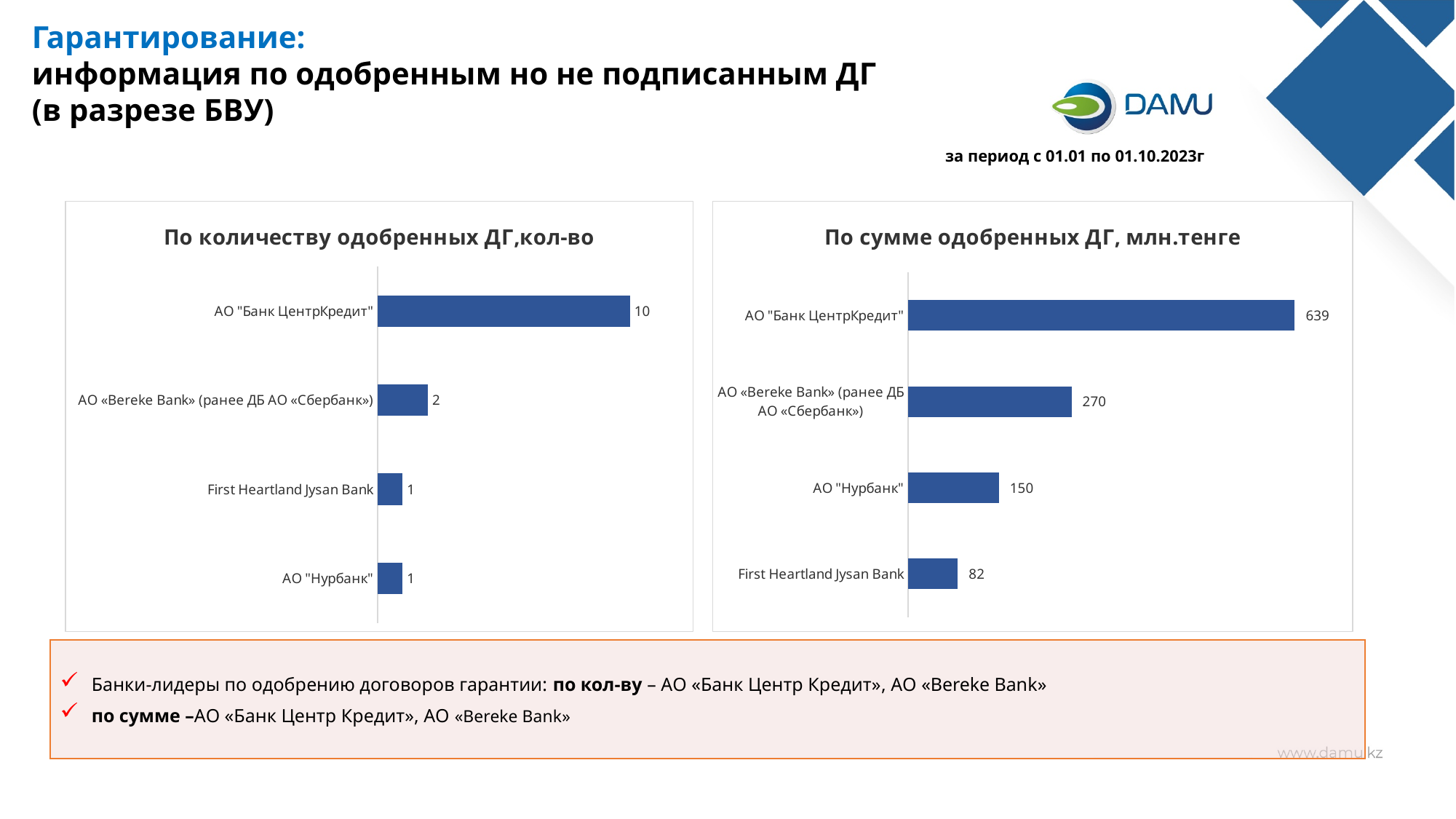
In the chart "По сумме одобренных ДГ, млн.тенге", what is the value for АО «Bereke Bank» (ранее ДБ АО «Сбербанк»)? 270 In the chart "По сумме одобренных ДГ, млн.тенге", what is the value for First Heartland Jysan Bank? 82 In the chart "По сумме одобренных ДГ, млн.тенге", what is the difference between АО "Банк ЦентрКредит" and АО «Bereke Bank» (ранее ДБ АО «Сбербанк»)? 369 In the chart "По сумме одобренных ДГ, млн.тенге", which is larger: АО "Нурбанк" or First Heartland Jysan Bank? АО "Нурбанк" In the chart "По количеству одобренных ДГ,кол-во", what is the value for АО "Банк ЦентрКредит"? 10 In the chart "По сумме одобренных ДГ, млн.тенге", which bank has the lowest value? First Heartland Jysan Bank In the chart "По количеству одобренных ДГ,кол-во", what is the difference between АО "Банк ЦентрКредит" and АО «Bereke Bank» (ранее ДБ АО «Сбербанк»)? 8 How many banks are shown in the chart "По количеству одобренных ДГ,кол-во"? 4 What is the title of the left chart on the slide? По количеству одобренных ДГ,кол-во In the chart "По количеству одобренных ДГ,кол-во", which bank has the highest value? АО "Банк ЦентрКредит" In the chart "По сумме одобренных ДГ, млн.тенге", what is the value for АО "Нурбанк"? 150 What kind of chart is "По сумме одобренных ДГ, млн.тенге"? Bar chart